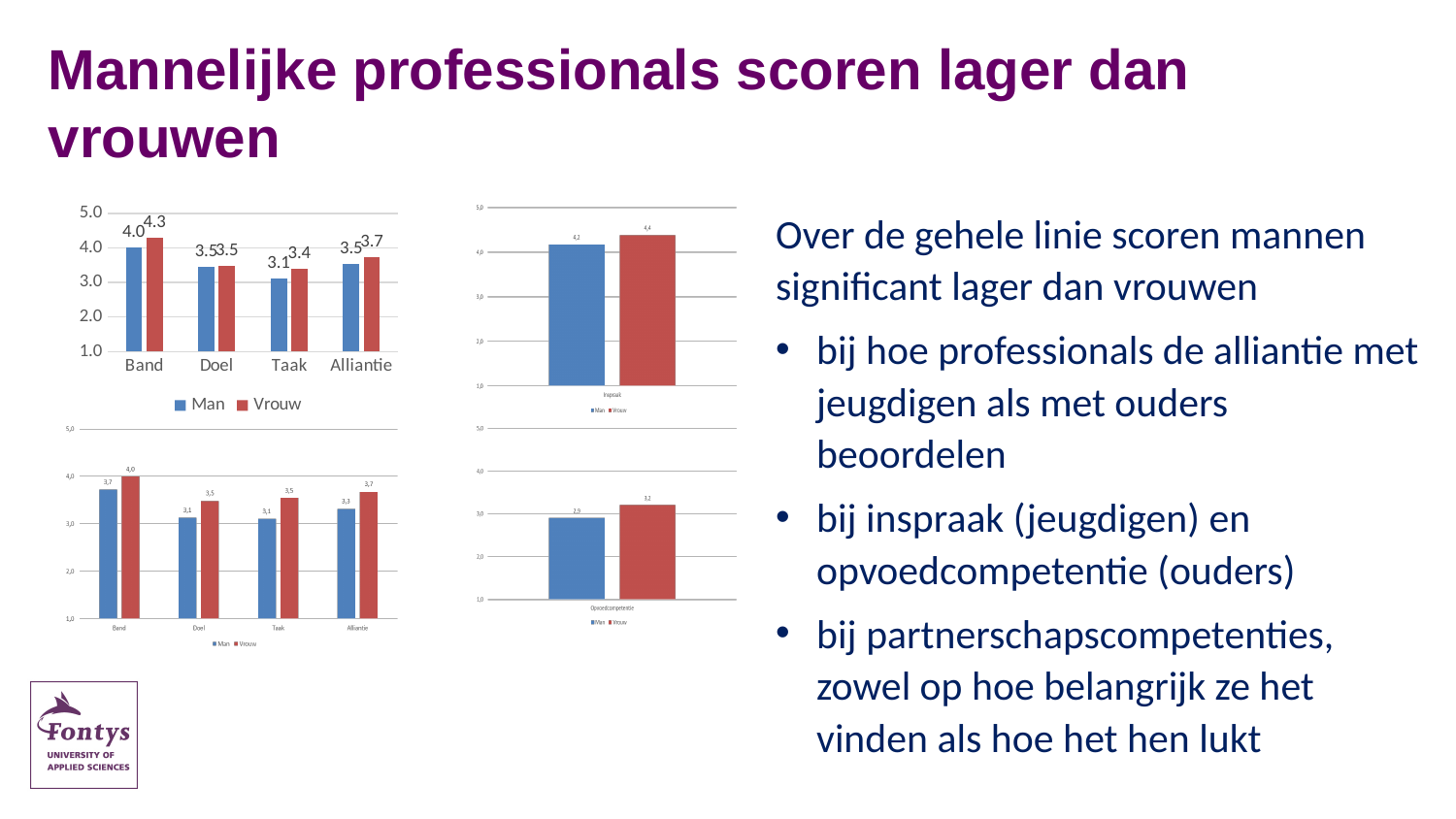
In the top-left chart, what is the difference between the Vrouw and Man values for Alliantie? 0.2 In the top-left chart, which series is shown in red? Vrouw In the top-left chart, what is the value for Vrouw in the Taak category? 3.4 What type of chart is the top-left chart? bar chart How many series does the legend of the top-left chart list? 2 How many categories are shown on the x axis of the top-left chart? 4 In the bottom-left chart, what is the value for Vrouw in the Band category? 4,0 In the top-left chart, which category has the lowest Man value? Taak In the top-left chart, which category has the highest Vrouw value? Band In the bottom-left chart, what is the value for Man in the Doel category? 3,1 In the top-left chart, what is the value for Man in the Band category? 4.0 In the bottom-left chart, is the Man value for Alliantie greater or less than 3,0? greater